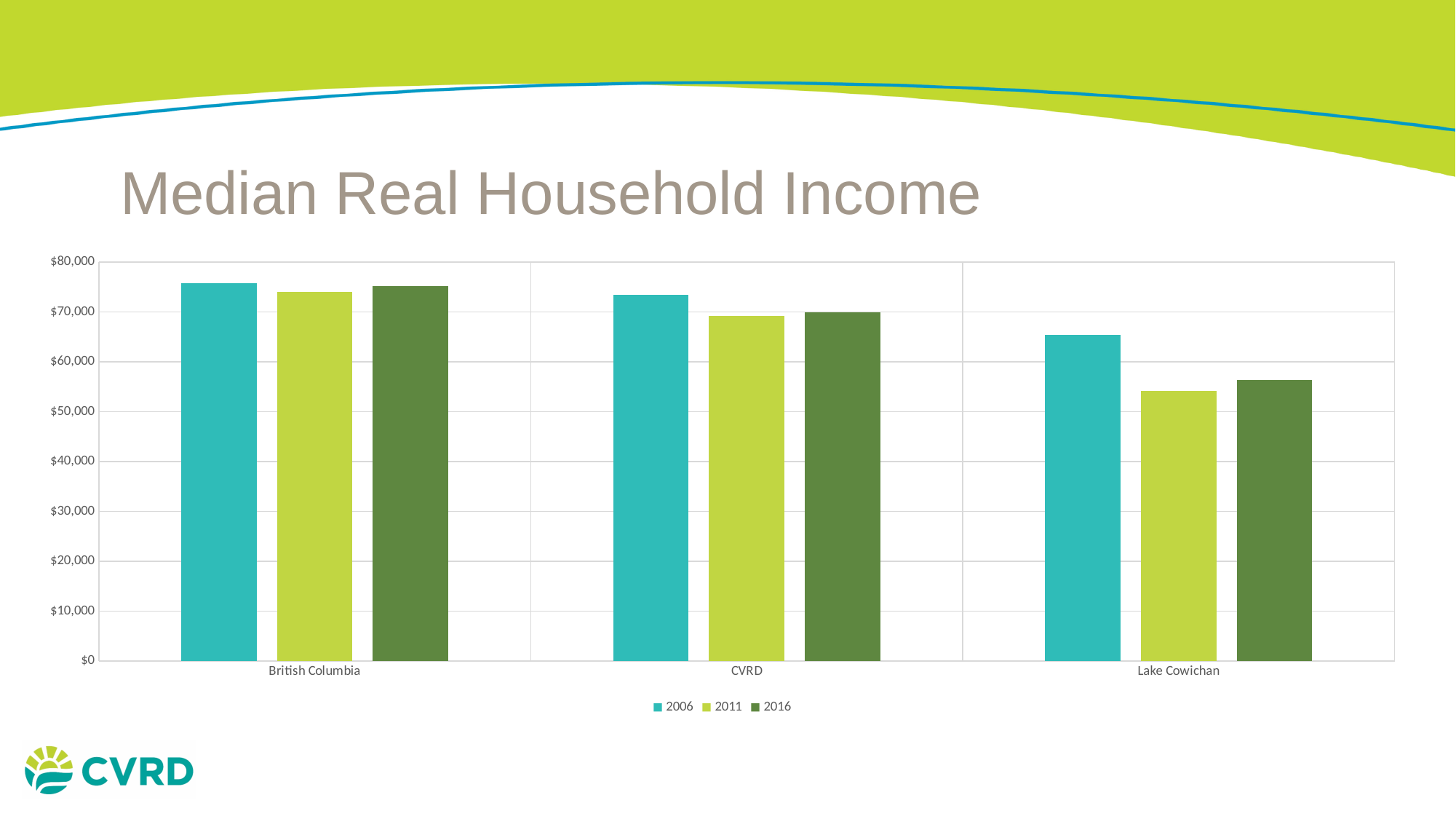
How many series does the legend list? 3 What kind of chart is shown on the slide? bar chart How many categories are shown on the x axis? 3 Is the 2011 value for Lake Cowichan greater or less than $60,000? less Which is larger for 2006, British Columbia or Lake Cowichan? British Columbia Which legend entry is shown in the darkest green colour? 2016 Is the 2006 value for Lake Cowichan greater or less than $60,000? greater Which category has the highest 2006 value? British Columbia What is the title of the chart? Median Real Household Income Which category has the lowest 2011 value? Lake Cowichan Is the 2006 value for British Columbia greater or less than $70,000? greater Which is larger for Lake Cowichan, the 2011 value or the 2016 value? 2016